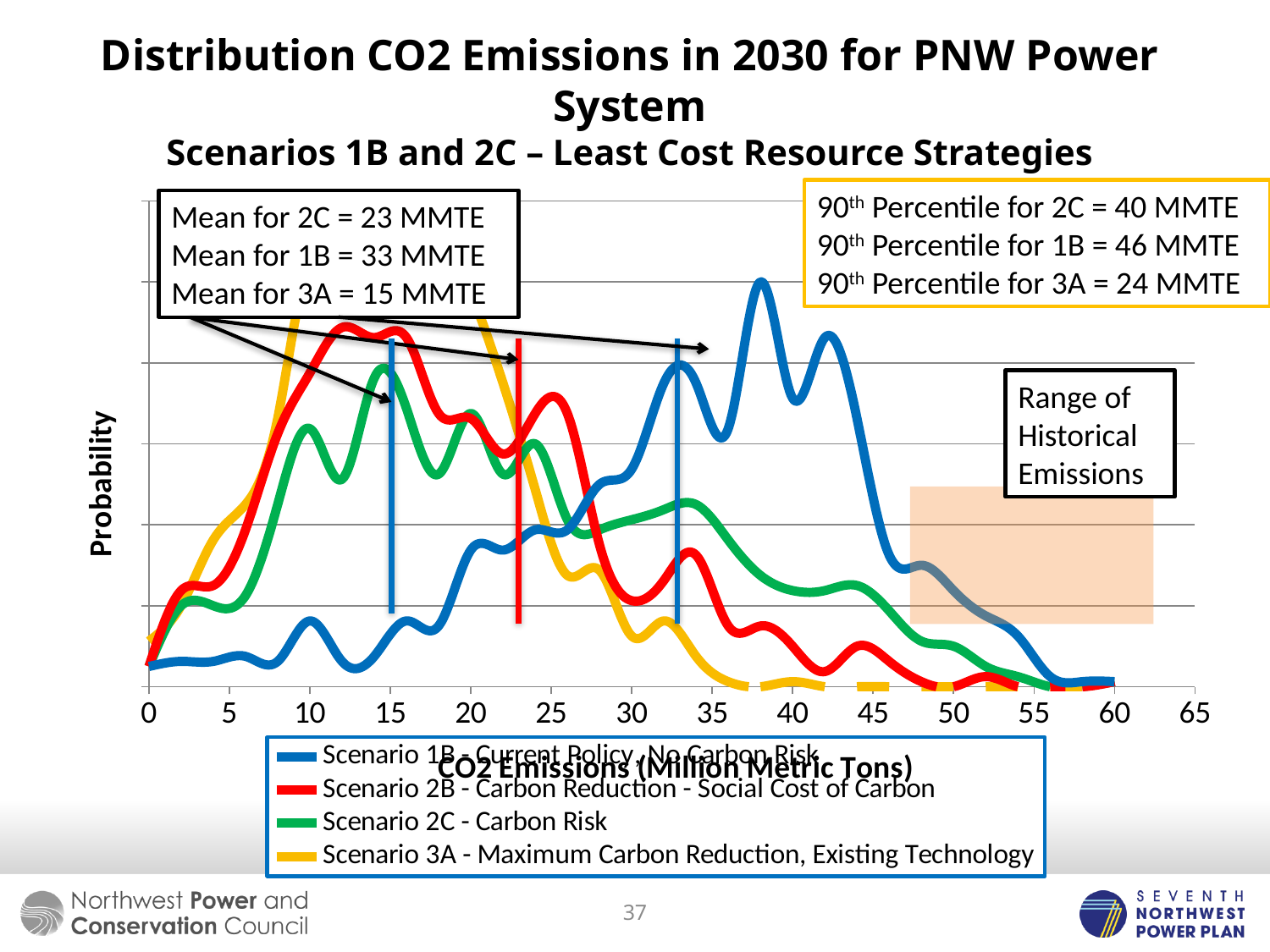
According to the annotation, what is the mean CO2 emissions for Scenario 1B? 33 MMTE According to the annotation, what is the mean CO2 emissions for Scenario 2C? 23 MMTE According to the annotation, what is the mean CO2 emissions for Scenario 3A? 15 MMTE Is the 90th percentile for Scenario 2C larger or smaller than the 90th percentile for Scenario 1B? Smaller Which scenario has the highest mean CO2 emissions among those listed in the annotation: 1B, 2C or 3A? Scenario 1B What is the difference between the mean CO2 emissions for Scenario 1B and Scenario 2C? 10 MMTE What kind of chart is shown on the slide? Line chart Which scenario has the lowest 90th percentile CO2 emissions among those listed: 1B, 2C or 3A? Scenario 3A What is the 90th percentile CO2 emissions for Scenario 1B as stated on the slide? 46 MMTE What is the label of the x axis? CO2 Emissions (Million Metric Tons) What is the 90th percentile CO2 emissions for Scenario 3A as stated on the slide? 24 MMTE How many series does the legend list? 4